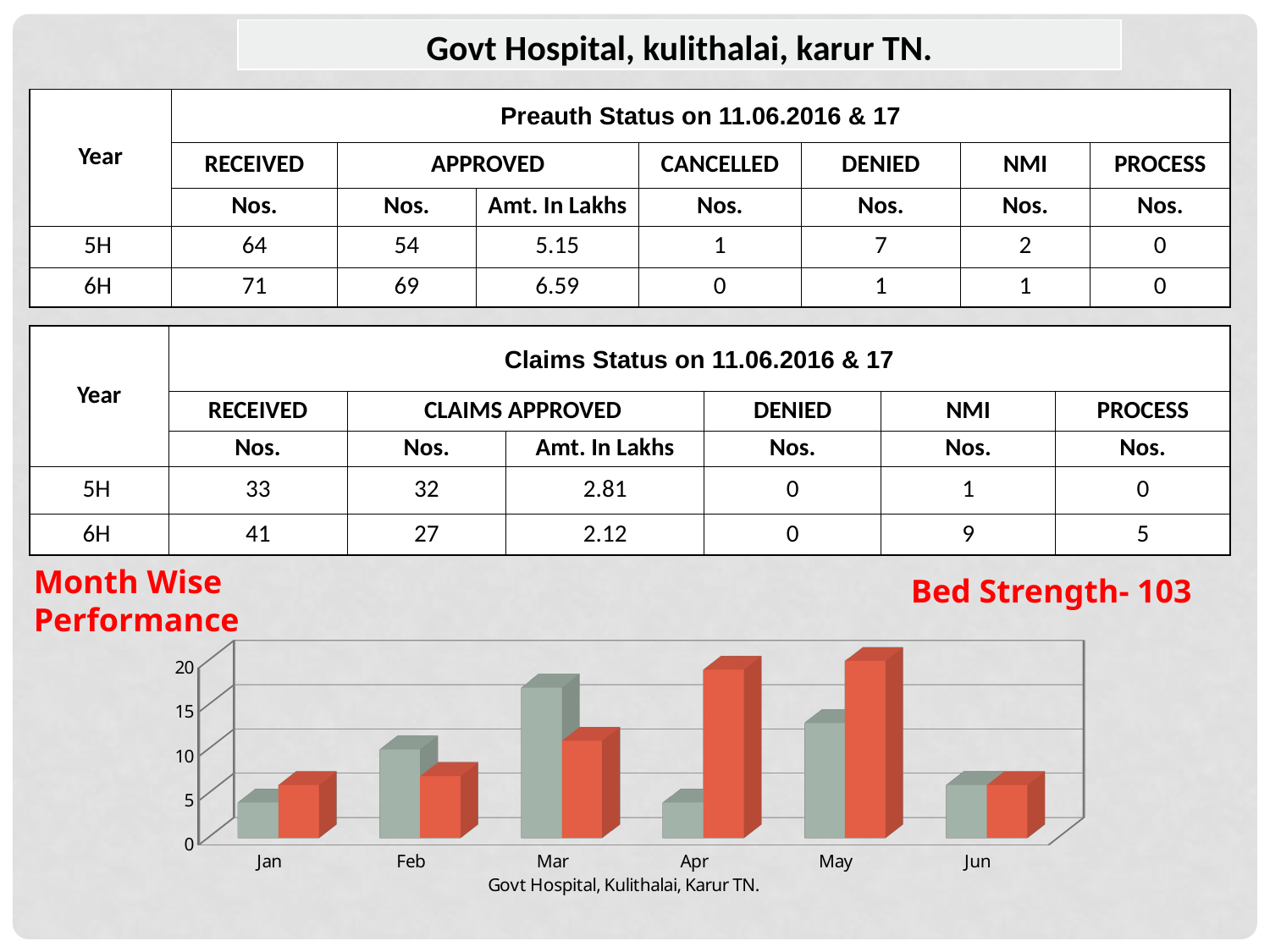
In the Month Wise Performance chart, is the red bar for Apr greater or less than 15? greater In the Month Wise Performance chart, is the grey bar for May greater or less than 10? greater What kind of chart is shown under the heading 'Month Wise Performance'? bar chart What is the highest value labelled on the y axis of the Month Wise Performance chart? 20 In the Month Wise Performance chart, is the red bar for Feb greater or less than 10? less How many months are shown on the x axis of the Month Wise Performance chart? 6 In the Month Wise Performance chart, for Apr, is the grey bar or the red bar taller? red In the Month Wise Performance chart, for Mar, is the grey bar or the red bar taller? grey What text appears below the x axis of the Month Wise Performance chart? Govt Hospital, Kulithalai, Karur TN. In the Month Wise Performance chart, which month has the tallest grey bar? Mar